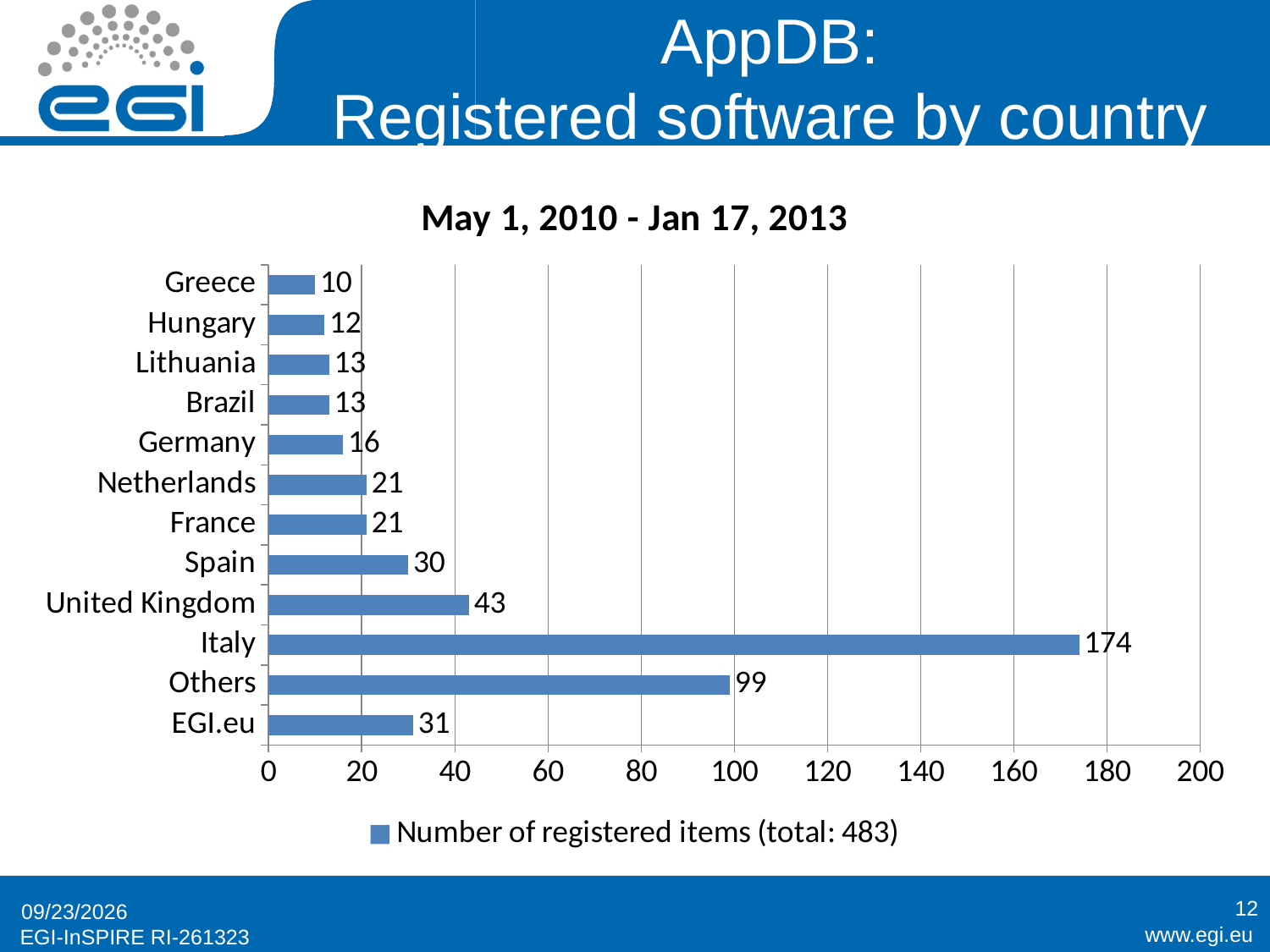
What is the number of registered items for EGI.eu? 31 What is the title of the chart? May 1, 2010 - Jan 17, 2013 What kind of chart is shown on the slide? bar chart How many categories are shown on the chart? 12 What is the difference between the number of registered items for Italy and Others? 75 Which category has the highest number of registered items? Italy What is the number of registered items for the United Kingdom? 43 Which category has the lowest number of registered items? Greece Is the value for Others greater or less than 100? less What is the number of registered items for Italy? 174 Which has more registered items, Spain or Germany? Spain How many series does the legend list? 1